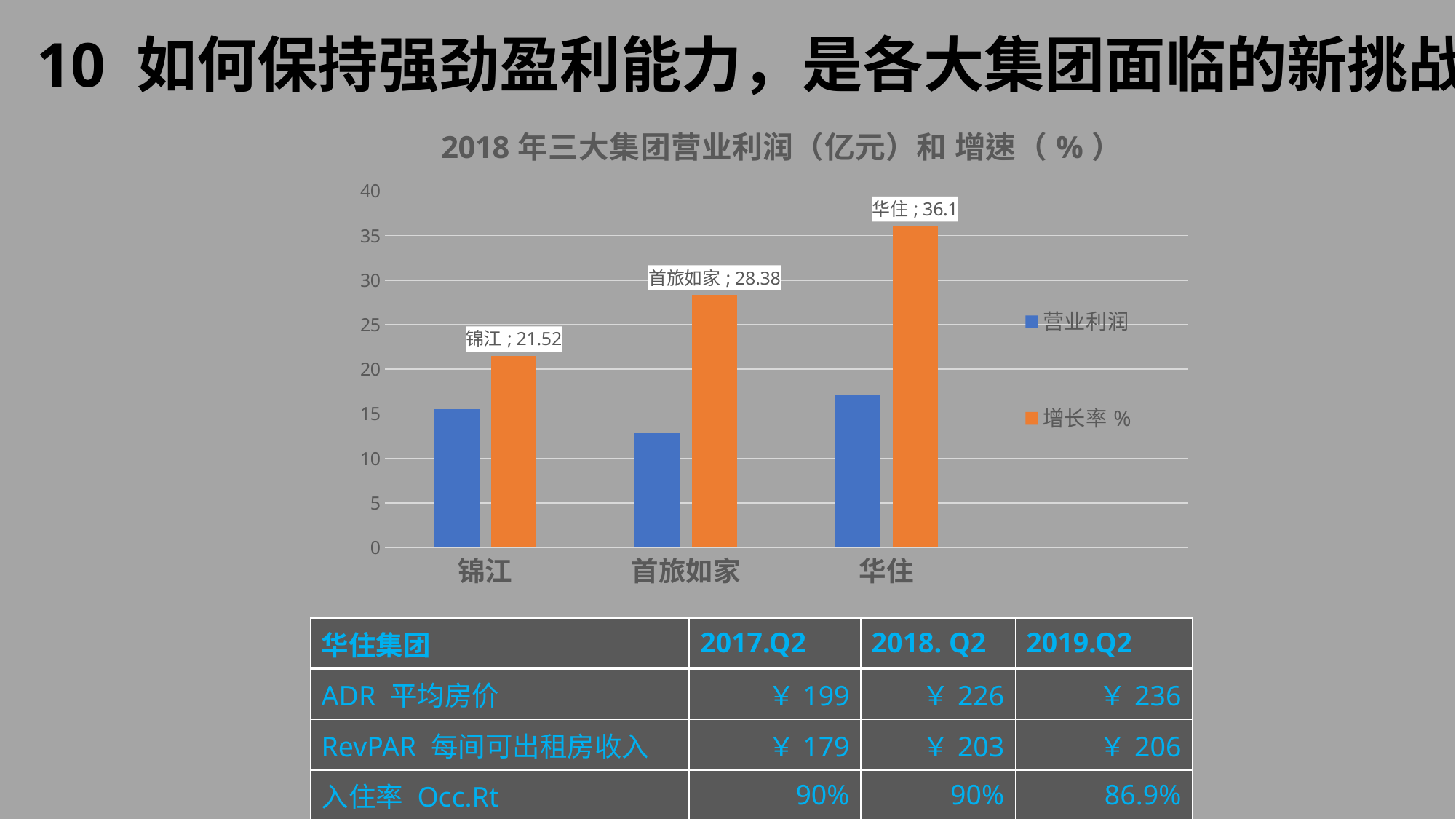
Is the 营业利润 value for 首旅如家 greater or less than 15? less What kind of chart is shown on the slide? Bar chart Is the 营业利润 value for 华住 greater or less than 15? greater Which group has the highest 增长率 %? 华住 What is the difference between the 增长率 % of 华住 and 锦江? 14.58 Which group has the lowest 增长率 %? 锦江 Which group has the larger 营业利润 bar, 锦江 or 首旅如家? 锦江 What is the 增长率 % value for 华住? 36.1 What is the 增长率 % value for 首旅如家? 28.38 How many series does the chart legend list? 2 What is the 增长率 % value for 锦江? 21.52 How many groups are shown on the x axis of the chart? 3